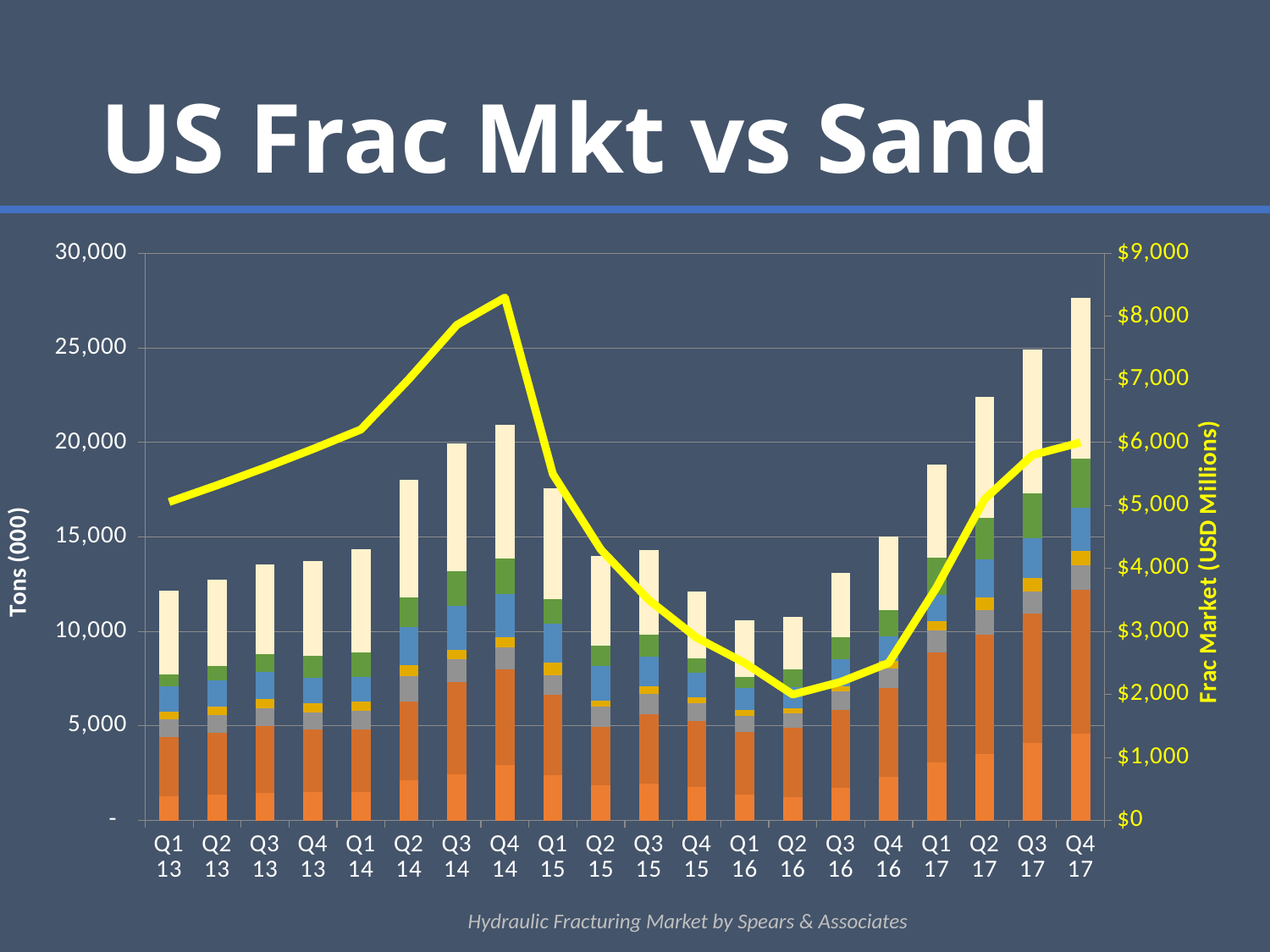
Is the total stacked bar for Q1 13 greater or less than 15,000? less Which quarter has the tallest stacked bar? Q4 17 In which quarter does the yellow Frac Market line reach its highest point? Q4 14 How many quarters are shown along the x axis? 20 In which quarter does the yellow Frac Market line reach its lowest point? Q2 16 Is the Frac Market line value for Q2 16 greater or less than $3,000? less What kind of chart is shown on the slide? A stacked bar chart with a line overlay What is the title of the left vertical axis? Tons (000) Is the total stacked bar for Q4 17 greater or less than 25,000? greater Does the yellow Frac Market line rise or fall between Q4 14 and Q2 16? Fall Which has the taller stacked bar, Q1 13 or Q4 17? Q4 17